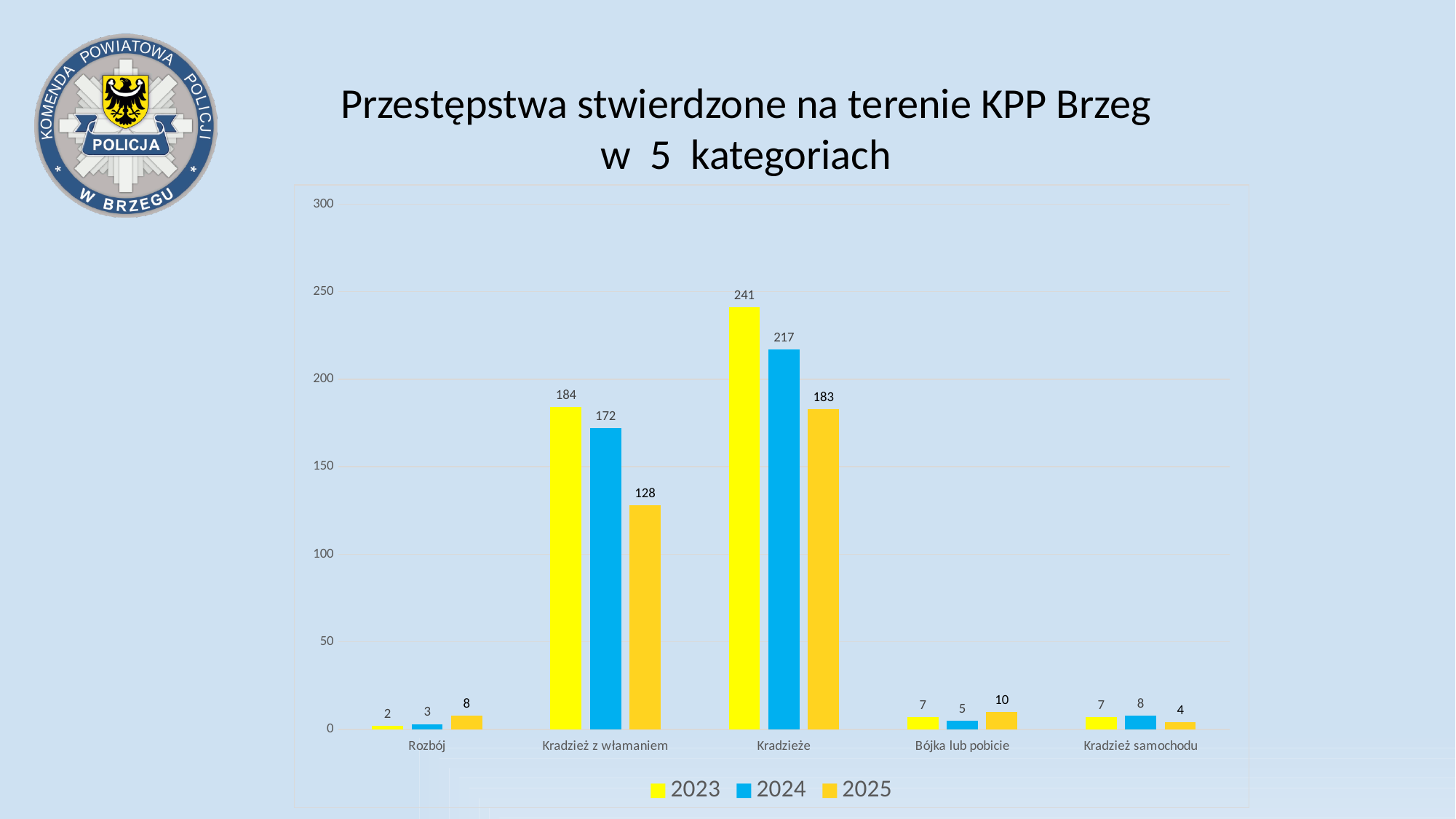
How many series does the legend list? 3 What is the difference between the 2023 and 2025 values for Kradzieże? 58 Which category has the lowest value in 2023? Rozbój What is the value for Kradzież z włamaniem in 2025? 128 What kind of chart is shown on the slide? bar chart How many categories are shown on the x axis? 5 Which colour represents the 2025 series in the legend? orange What is the value for Kradzieże in 2023? 241 What is the value for Bójka lub pobicie in 2024? 5 Is the 2024 value for Kradzież z włamaniem greater or less than 150? greater Which is larger for Kradzież samochodu: the 2024 value or the 2025 value? 2024 Which category has the highest value in 2024? Kradzieże